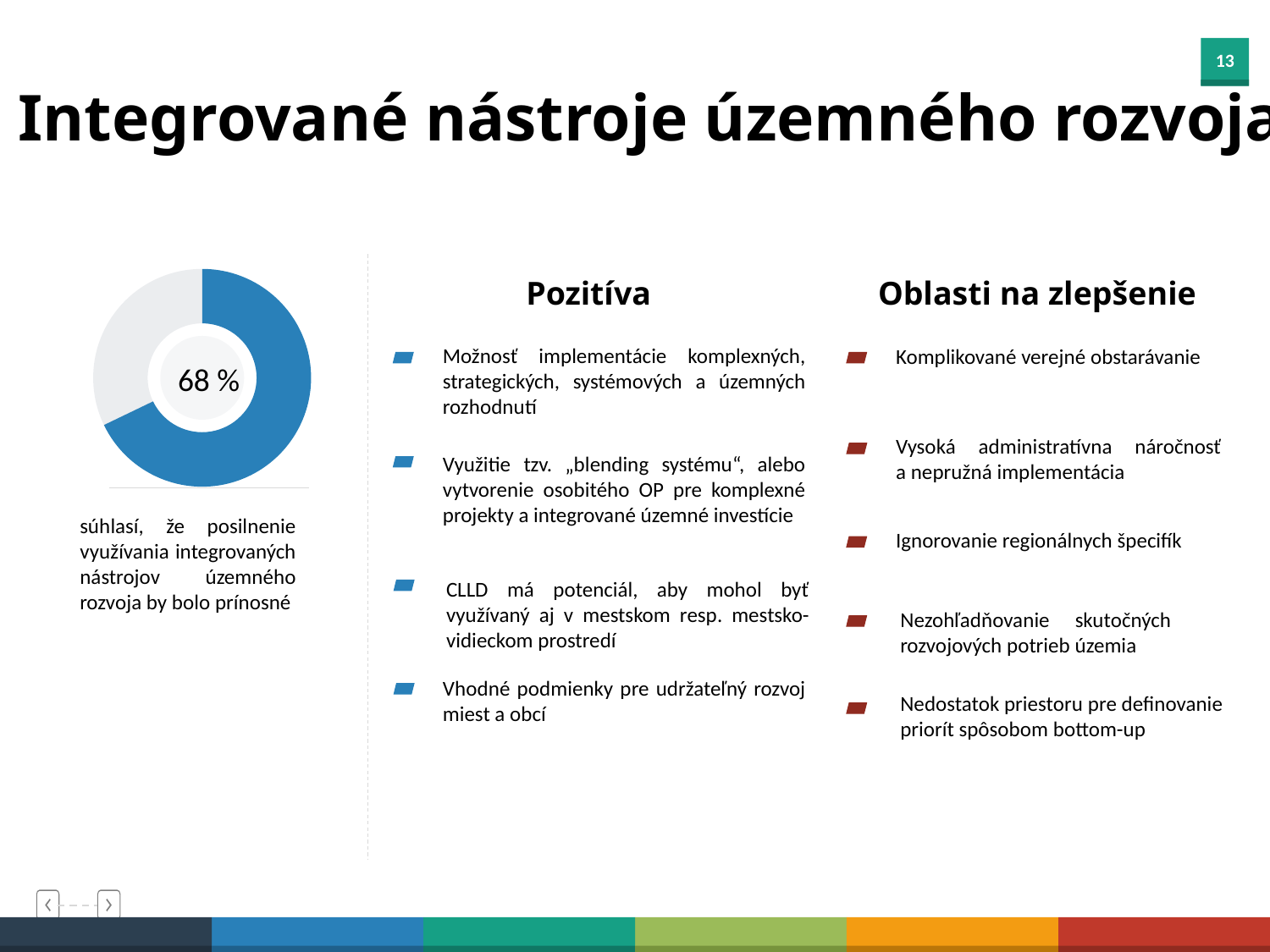
What percentage is printed in the centre of the donut chart? 68 % Which slice of the donut chart is larger, the blue one or the grey one? The blue one Is the value shown in the donut chart greater or less than 50 %? greater What kind of chart is shown on the left of the slide? Donut (pie) chart How many slices does the donut chart have? 2 What share of the donut chart does the blue slice represent? 68 % According to the text under the donut chart, what does the 68 % represent? Those who agree that strengthening the use of integrated territorial development tools would be beneficial What colour is the larger slice of the donut chart? Blue